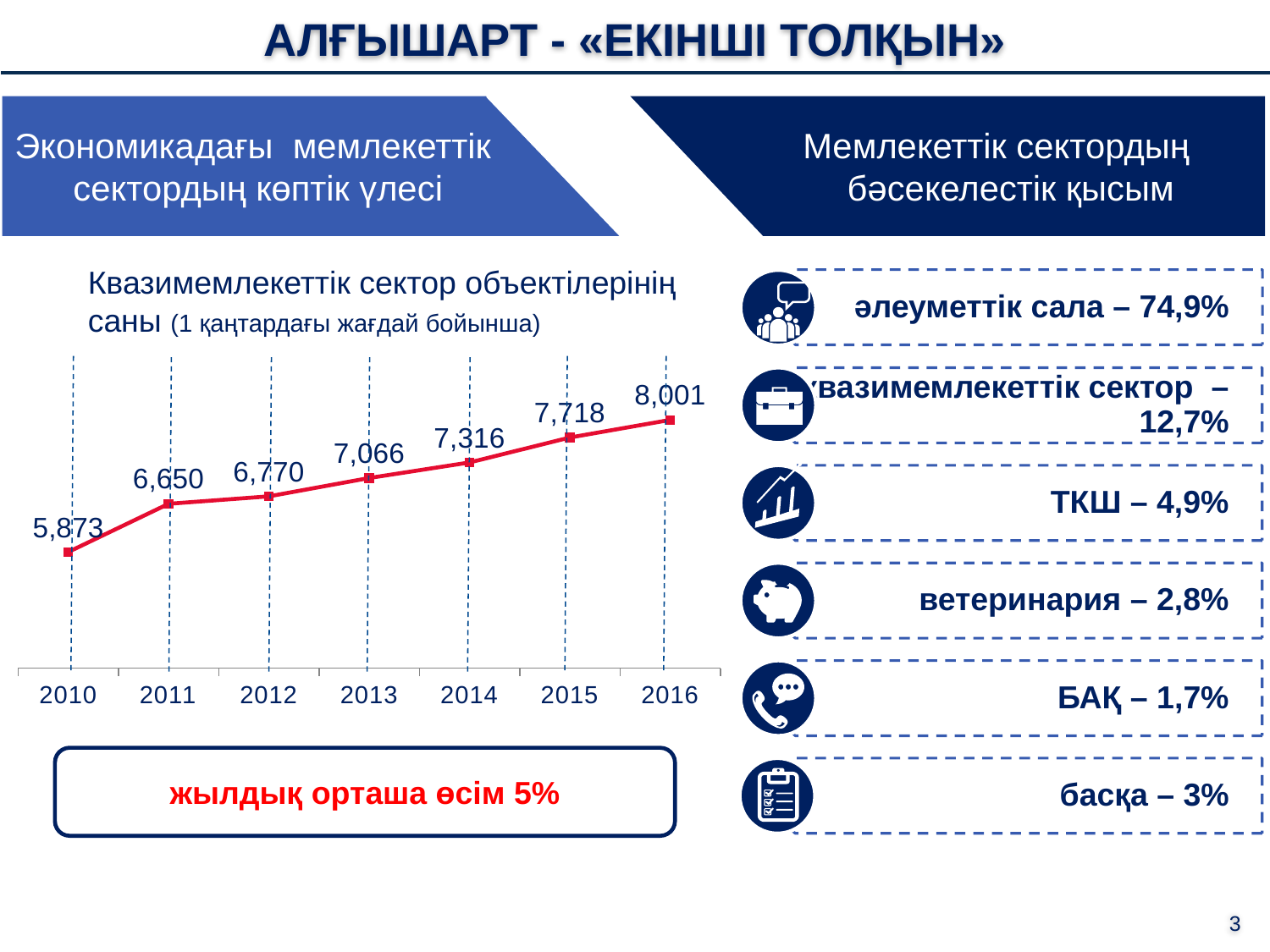
What is the value for 2014 in the chart? 7,316 Which is larger, the value for 2015 or the value for 2014? 2015 What is the difference between the values for 2016 and 2010? 2,128 Which year has the highest value in the chart? 2016 What is the difference between the values for 2012 and 2011? 120 What type of chart is shown on the slide? line chart What is the value for 2016 in the chart? 8,001 How many years are plotted on the x axis of the chart? 7 What is the value for 2013 in the chart? 7,066 Do the values rise or fall from 2010 to 2016? rise Which year has the lowest value in the chart? 2010 What is the value for 2010 in the chart? 5,873